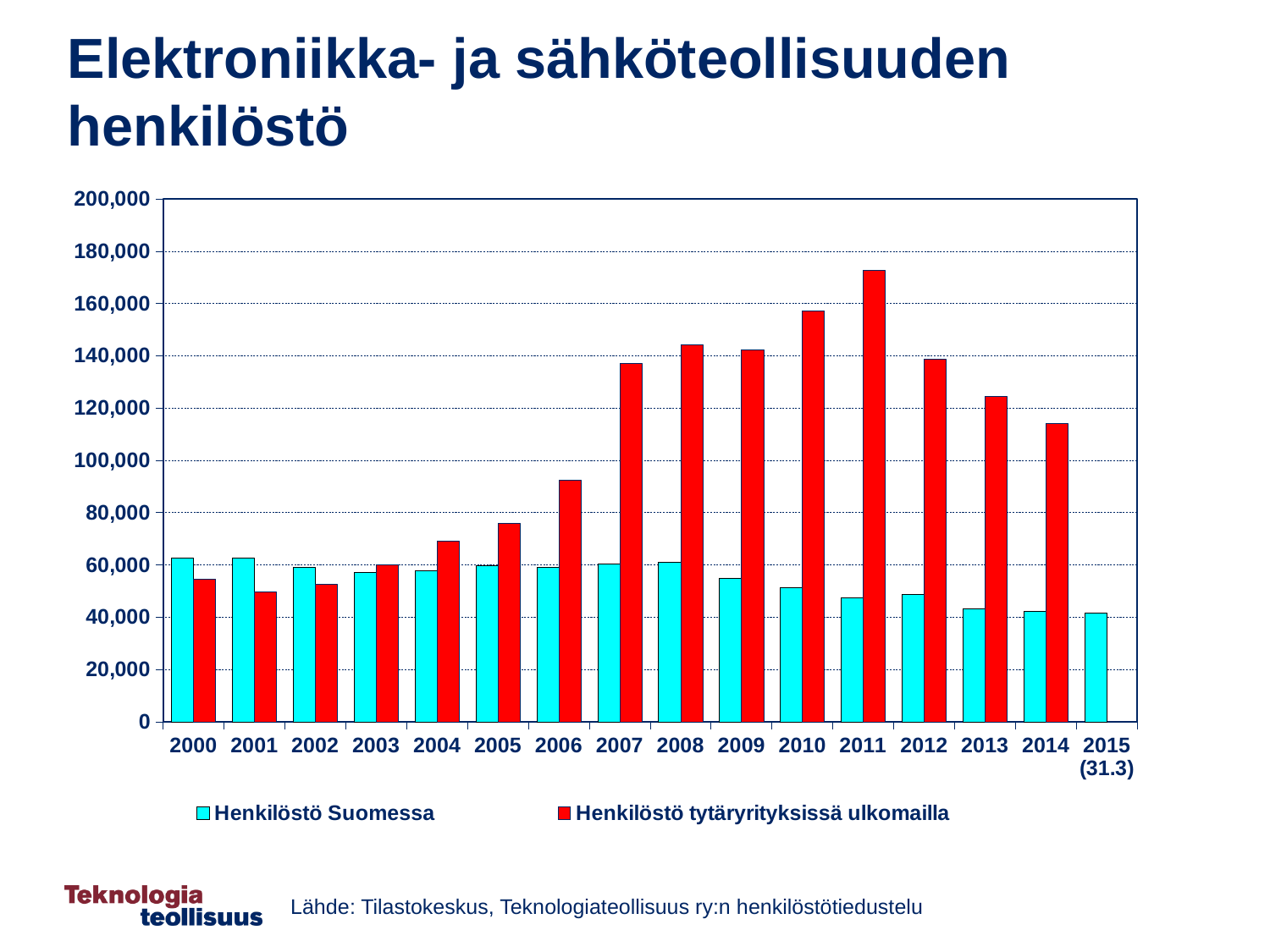
Which is larger in 2000, Henkilöstö Suomessa or Henkilöstö tytäryrityksissä ulkomailla? Henkilöstö Suomessa How many years are shown on the x axis? 16 Is the value for Henkilöstö Suomessa in 2014 greater or less than 60,000? less Which is larger in 2010, Henkilöstö Suomessa or Henkilöstö tytäryrityksissä ulkomailla? Henkilöstö tytäryrityksissä ulkomailla How many series does the legend list? 2 In which year is the value for Henkilöstö tytäryrityksissä ulkomailla lowest? 2001 What kind of chart is shown on the slide? bar chart What colour are the bars for Henkilöstö tytäryrityksissä ulkomailla? red In which year is the value for Henkilöstö tytäryrityksissä ulkomailla highest? 2011 Is the value for Henkilöstö tytäryrityksissä ulkomailla in 2007 greater or less than 120,000? greater Is the value for Henkilöstö tytäryrityksissä ulkomailla in 2011 greater or less than 160,000? greater Does the value for Henkilöstö Suomessa rise or fall from 2008 to 2015? fall